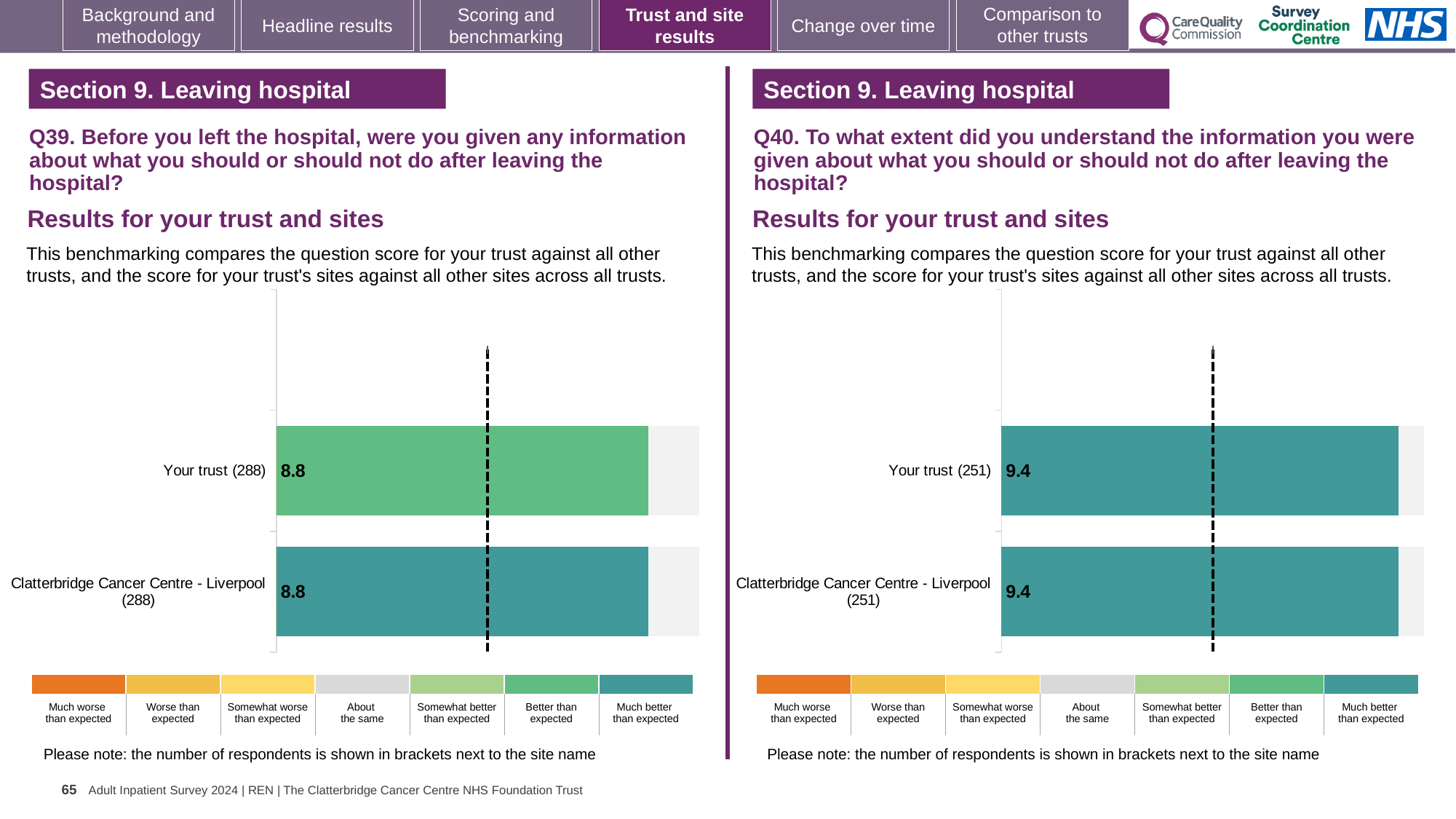
How many categories does the colour key below the Q40 chart on the right list? 7 On the Q39 chart on the left, what is the score for Clatterbridge Cancer Centre - Liverpool? 8.8 How many bars are plotted on the Q39 chart on the left? 2 On the Q39 chart on the left, what is the difference between the score for Your trust and the score for Clatterbridge Cancer Centre - Liverpool? 0 On the Q39 chart on the left, what is the score for Your trust? 8.8 On the Q40 chart on the right, what is the score for Clatterbridge Cancer Centre - Liverpool? 9.4 On the Q40 chart on the right, what is the difference between the score for Your trust and the score for Clatterbridge Cancer Centre - Liverpool? 0 On the Q40 chart on the right, how many respondents are shown in brackets for Clatterbridge Cancer Centre - Liverpool? 251 How many bars are plotted on the Q40 chart on the right? 2 What type of chart is used on the Q39 chart on the left? Bar chart On the Q40 chart on the right, what is the score for Your trust? 9.4 On the Q39 chart on the left, how many respondents are shown in brackets for Your trust? 288